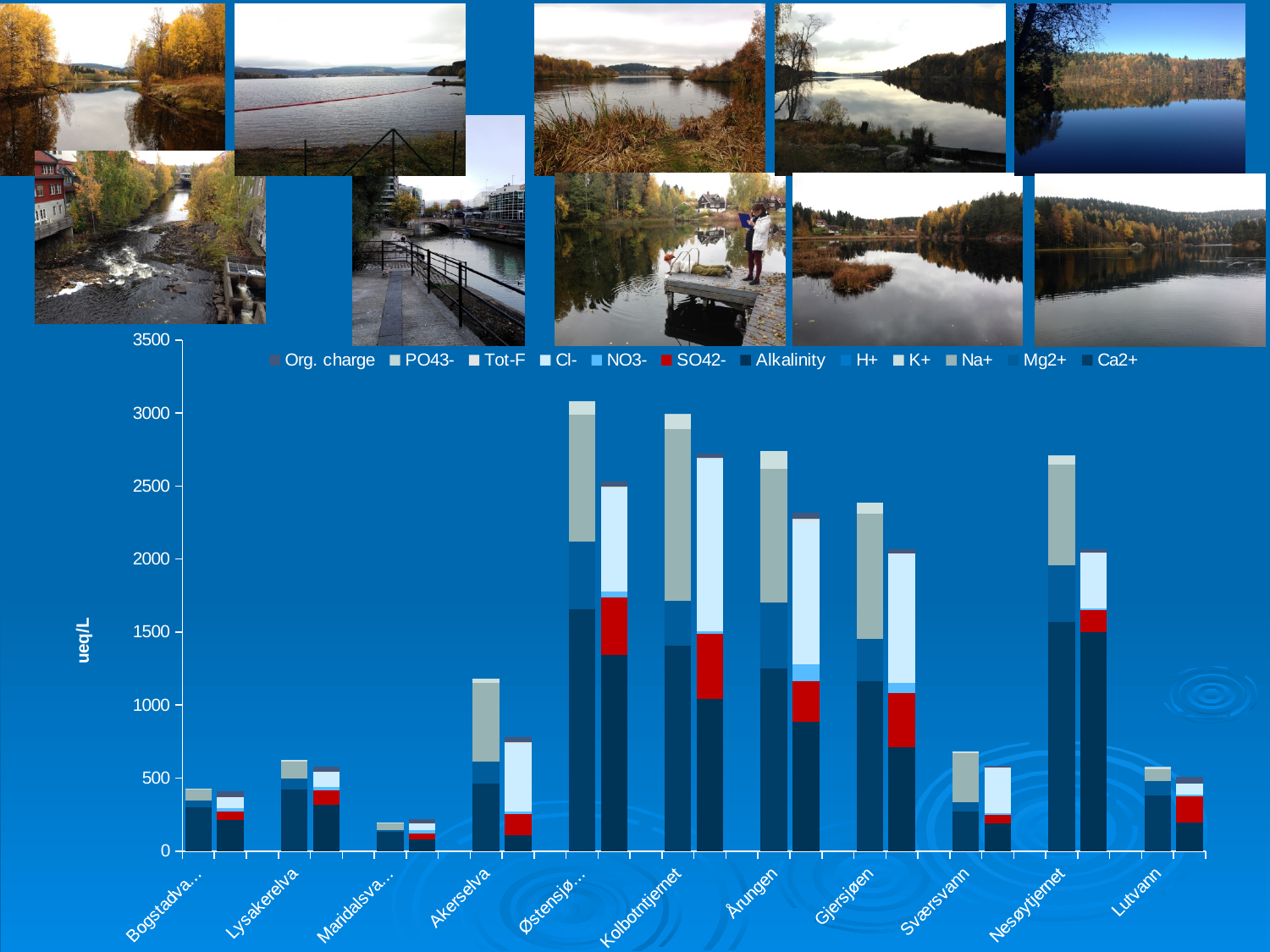
What is the highest value shown on the y axis? 3500 What is the label of the y axis? ueq/L How many bars are plotted for each category? 2 Which has the taller left bar, Sværsvann or Gjersjøen? Gjersjøen Which has the taller left bar, Kolbotntjernet or Lutvann? Kolbotntjernet Is the total of the left bar for Nesøytjernet greater or less than 2500? greater What kind of chart is shown on the slide? Stacked bar chart How many series does the legend list? 12 Is the total of the left bar for Akerselva greater or less than 1000? greater Is the total of the left bar for Lutvann greater or less than 1000? less How many categories are shown along the x axis? 11